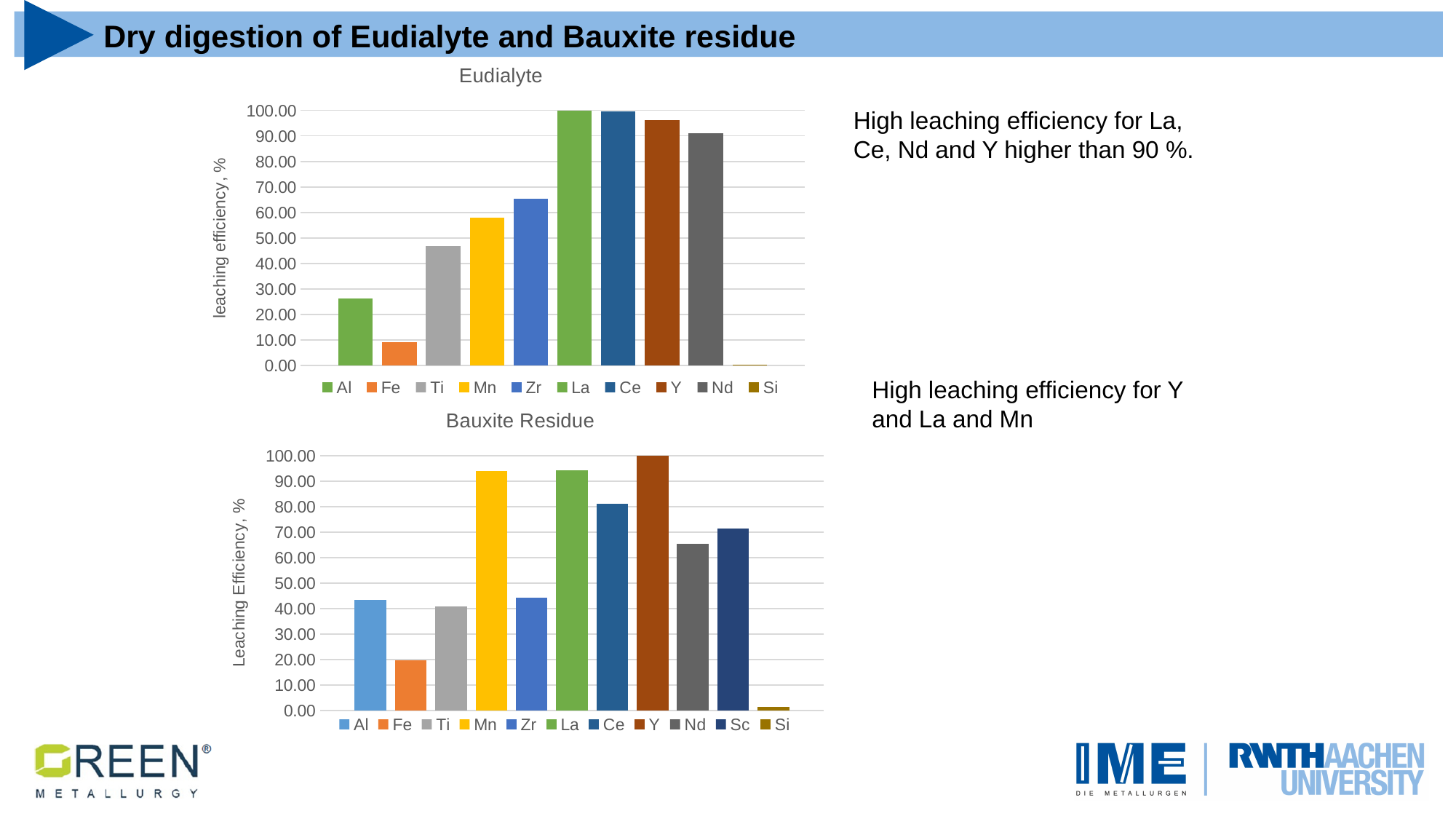
What kind of chart is the Eudialyte chart? bar chart In the Eudialyte chart, which is larger, the value for Mn or the value for Ti? Mn In the Bauxite Residue chart, is the value for Ce greater or less than 70.00? greater In the Bauxite Residue chart, which element has the highest leaching efficiency? Y In the Bauxite Residue chart, is the value for Fe greater or less than 30.00? less In the Eudialyte chart, is the value for Fe greater or less than 20.00? less What is the y-axis label of the Bauxite Residue chart? Leaching Efficiency, % How many entries does the legend of the Eudialyte chart list? 10 In the Eudialyte chart, which element has the lowest leaching efficiency? Si How many entries does the legend of the Bauxite Residue chart list? 11 In the Bauxite Residue chart, which element has the lowest leaching efficiency? Si